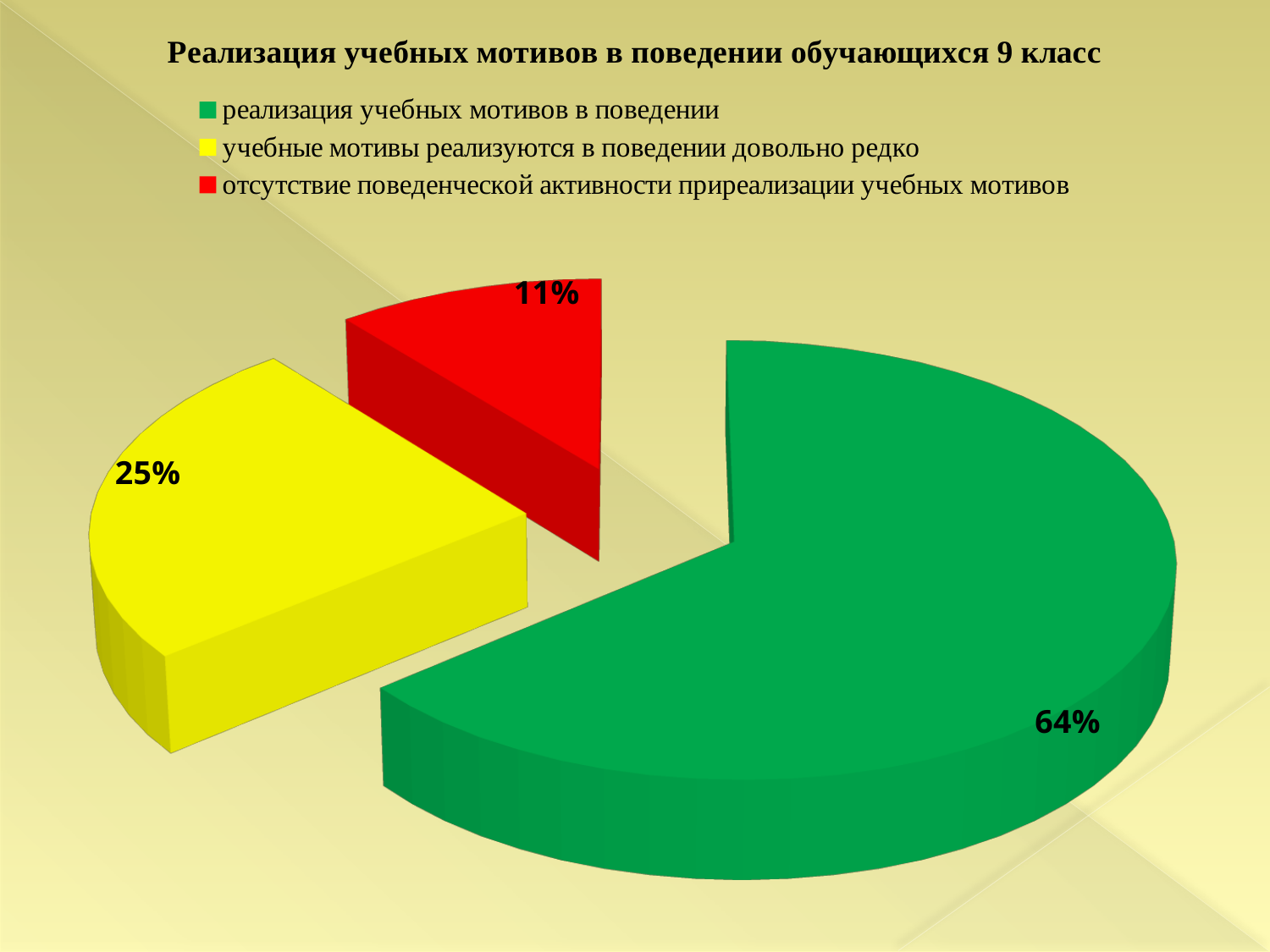
How many slices does the pie chart have? 3 What is the value for "учебные мотивы реализуются в поведении довольно редко"? 25% What is the title of the chart? Реализация учебных мотивов в поведении обучающихся 9 класс What is the difference between the share for "реализация учебных мотивов в поведении" and the share for "учебные мотивы реализуются в поведении довольно редко"? 39% How many entries does the legend list? 3 What is the value for "отсутствие поведенческой активности приреализации учебных мотивов"? 11% What colour is the slice for "отсутствие поведенческой активности приреализации учебных мотивов"? red Which category has the largest share of the pie? реализация учебных мотивов в поведении Which category has the smallest share of the pie? отсутствие поведенческой активности приреализации учебных мотивов What is the value for "реализация учебных мотивов в поведении"? 64% What kind of chart is shown on the slide? pie chart Which is larger: the share for "учебные мотивы реализуются в поведении довольно редко" or the share for "отсутствие поведенческой активности приреализации учебных мотивов"? учебные мотивы реализуются в поведении довольно редко